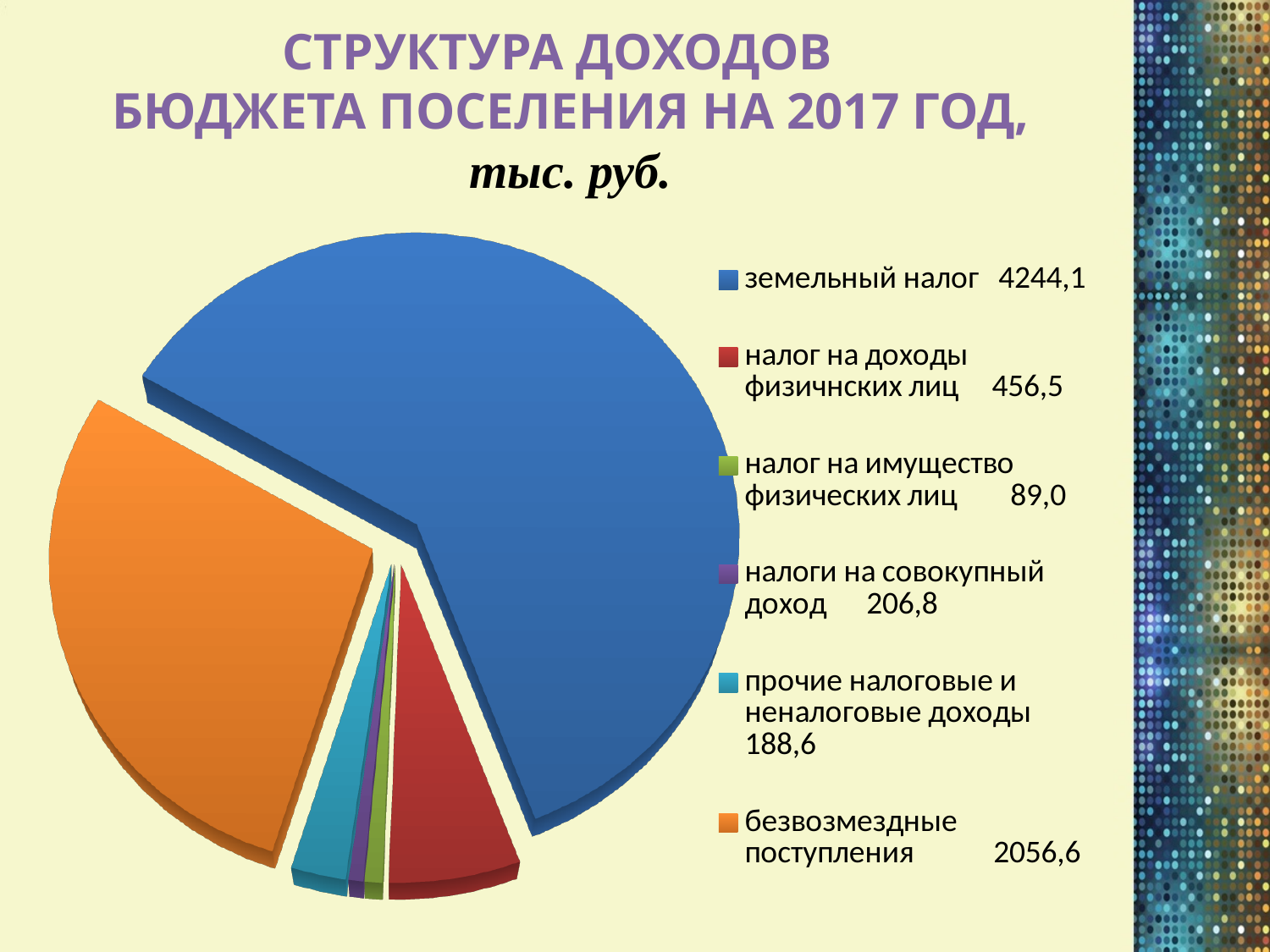
What is the value for земельный налог? 4244,1 What is the difference between налоги на совокупный доход and прочие налоговые и неналоговые доходы? 18,2 In what units are the values on the chart given, according to the title? тыс. руб. What kind of chart is shown on the slide? pie chart What is the value for налог на имущество физических лиц? 89,0 What is the difference between земельный налог and безвозмездные поступления? 2187,5 Which is larger: безвозмездные поступления or налог на доходы физических лиц? безвозмездные поступления How many categories does the pie chart have? 6 Which category has the smallest value? налог на имущество физических лиц What is the value for прочие налоговые и неналоговые доходы? 188,6 Which category has the largest value? земельный налог What is the value for безвозмездные поступления? 2056,6